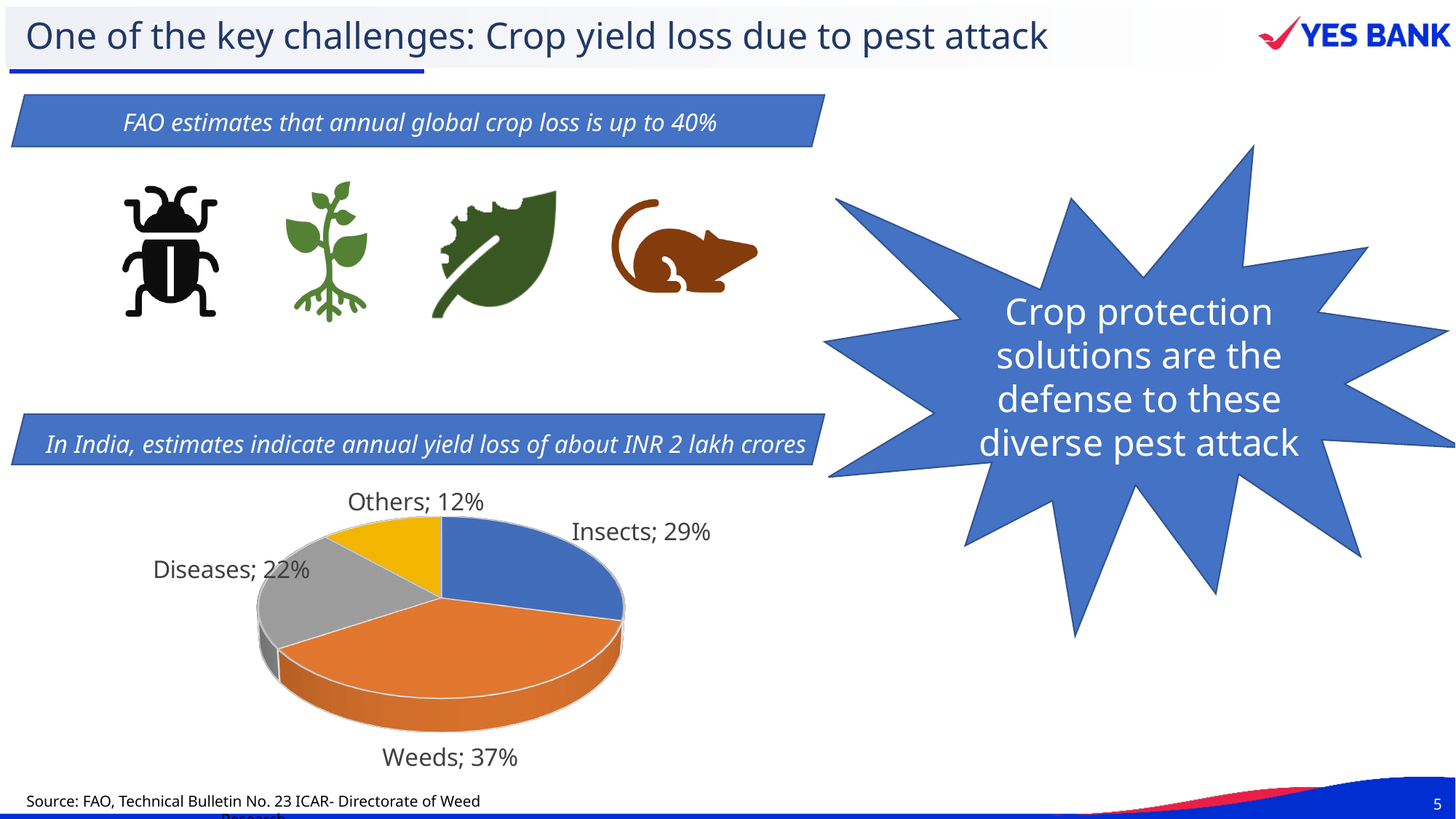
Which category has the largest slice in the pie chart? Weeds Which slice is larger, Diseases or Insects? Insects What is the combined share of the Insects and Weeds slices? 66% How many categories are shown in the pie chart? 4 What share of the pie chart is attributed to Weeds? 37% What is the difference in percentage points between the Weeds and Insects slices? 8 What kind of chart is shown on the slide? Pie chart What share of the pie chart is attributed to Diseases? 22% What share of the pie chart is attributed to Insects? 29% What share of the pie chart is attributed to Others? 12% Which category has the smallest slice in the pie chart? Others What colour is the Weeds slice in the pie chart? Orange